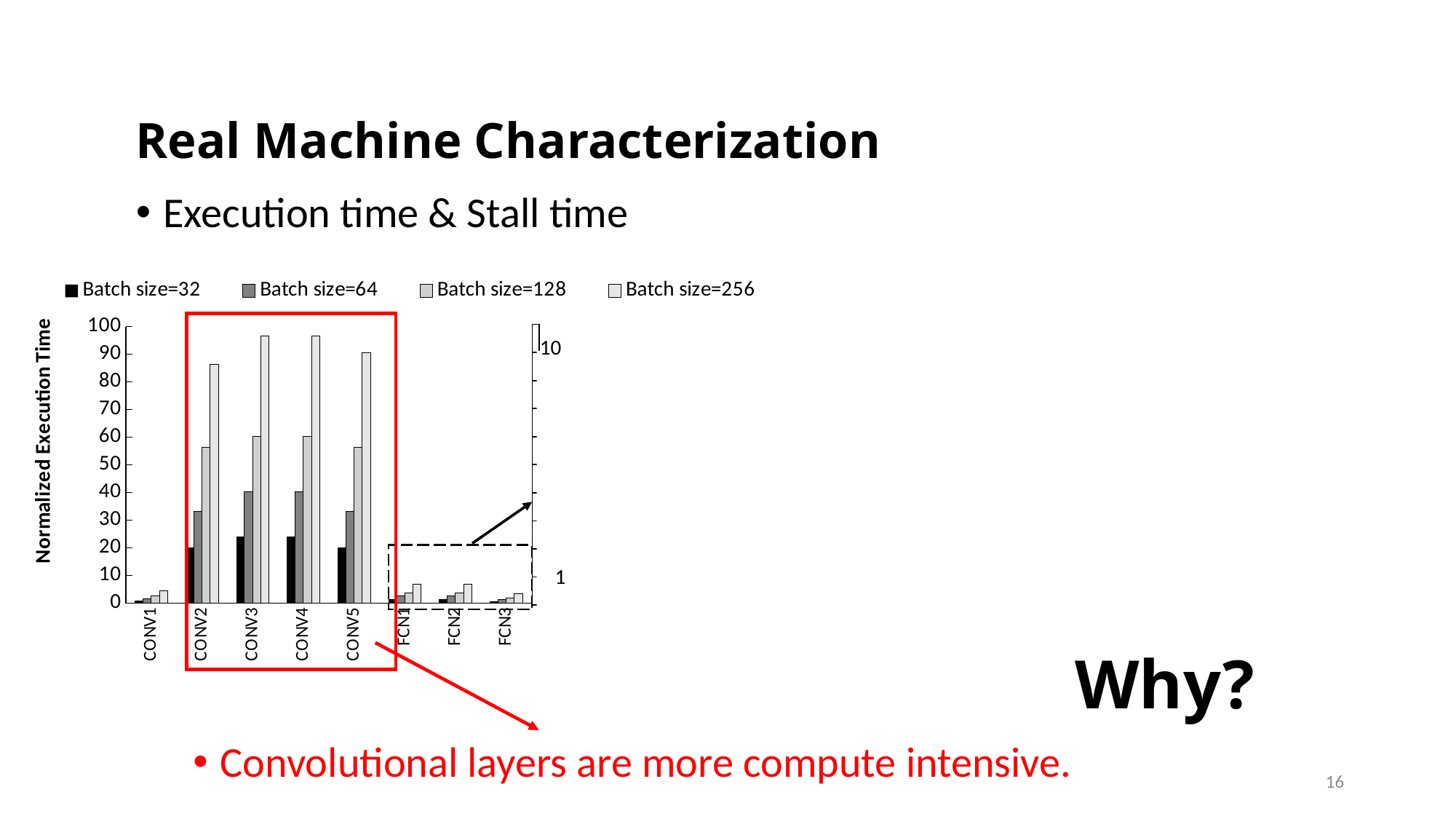
Which series is shown with black bars according to the legend? Batch size=32 How many categories are shown along the x axis? 8 Is the value for CONV3 at Batch size=256 greater or less than 90? greater Which has the larger value at Batch size=256, CONV1 or CONV2? CONV2 What kind of chart is shown on the slide? bar chart Is the value for CONV3 at Batch size=64 greater or less than 50? less How many series does the legend list? 4 Is the value for CONV1 at Batch size=256 greater or less than 10? less Within the CONV3 category, do the values rise or fall as the batch size increases from 32 to 256? rise What is the title of the y axis? Normalized Execution Time